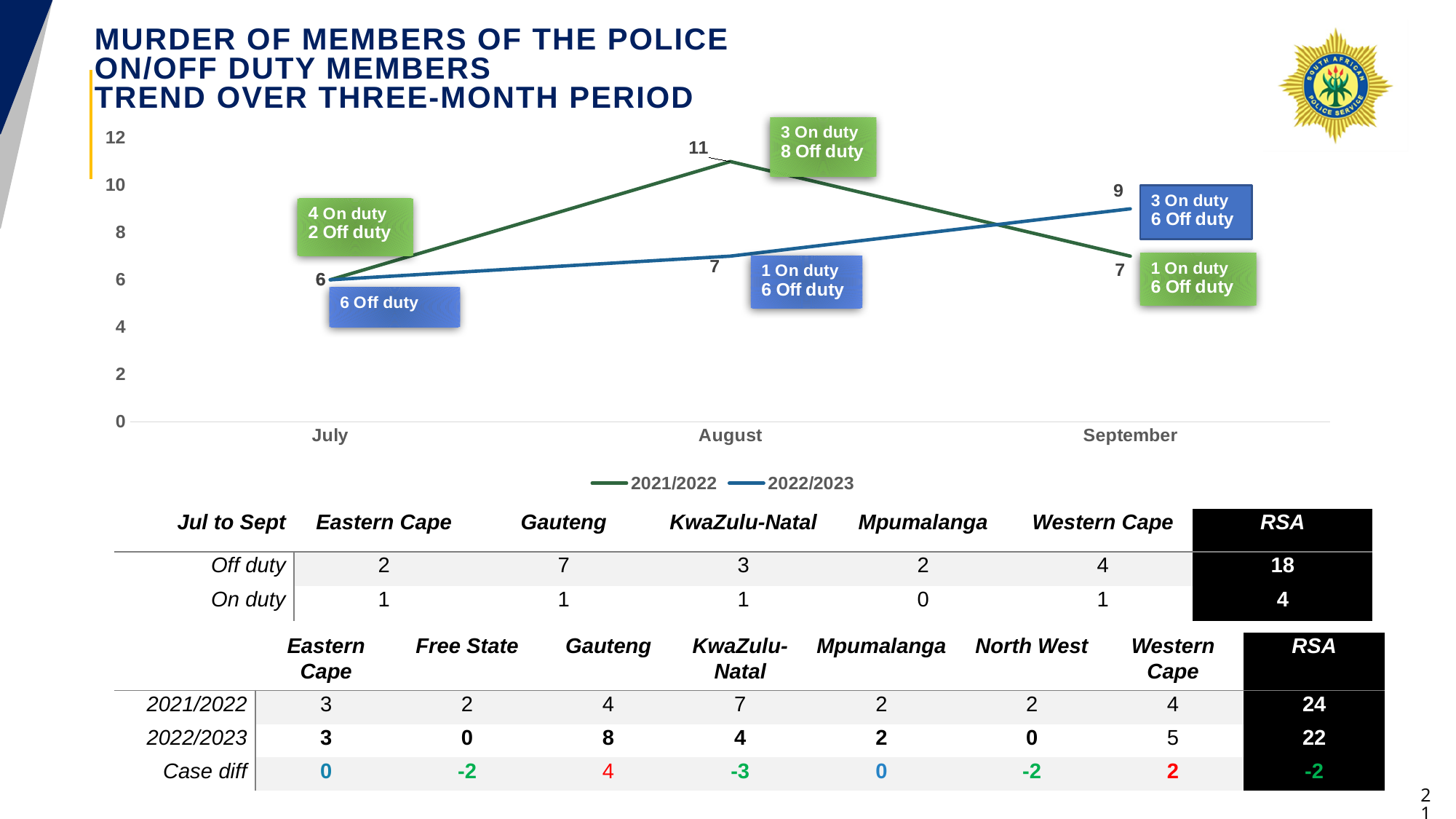
What is the difference between the 2021/2022 and 2022/2023 values in August? 4 In which month is the 2022/2023 series lowest? July What is the value for 2022/2023 in July? 6 Which series is drawn in green in the chart? 2021/2022 What kind of chart is shown on the slide? line chart In which month does the 2021/2022 series reach its highest value? August How many months are plotted along the x axis of the chart? 3 What is the value for 2022/2023 in September? 9 What is the value for 2021/2022 in August? 11 How many series does the chart legend list? 2 Does the 2022/2023 series rise or fall from July to September? rise Which series has the larger value in September, 2021/2022 or 2022/2023? 2022/2023